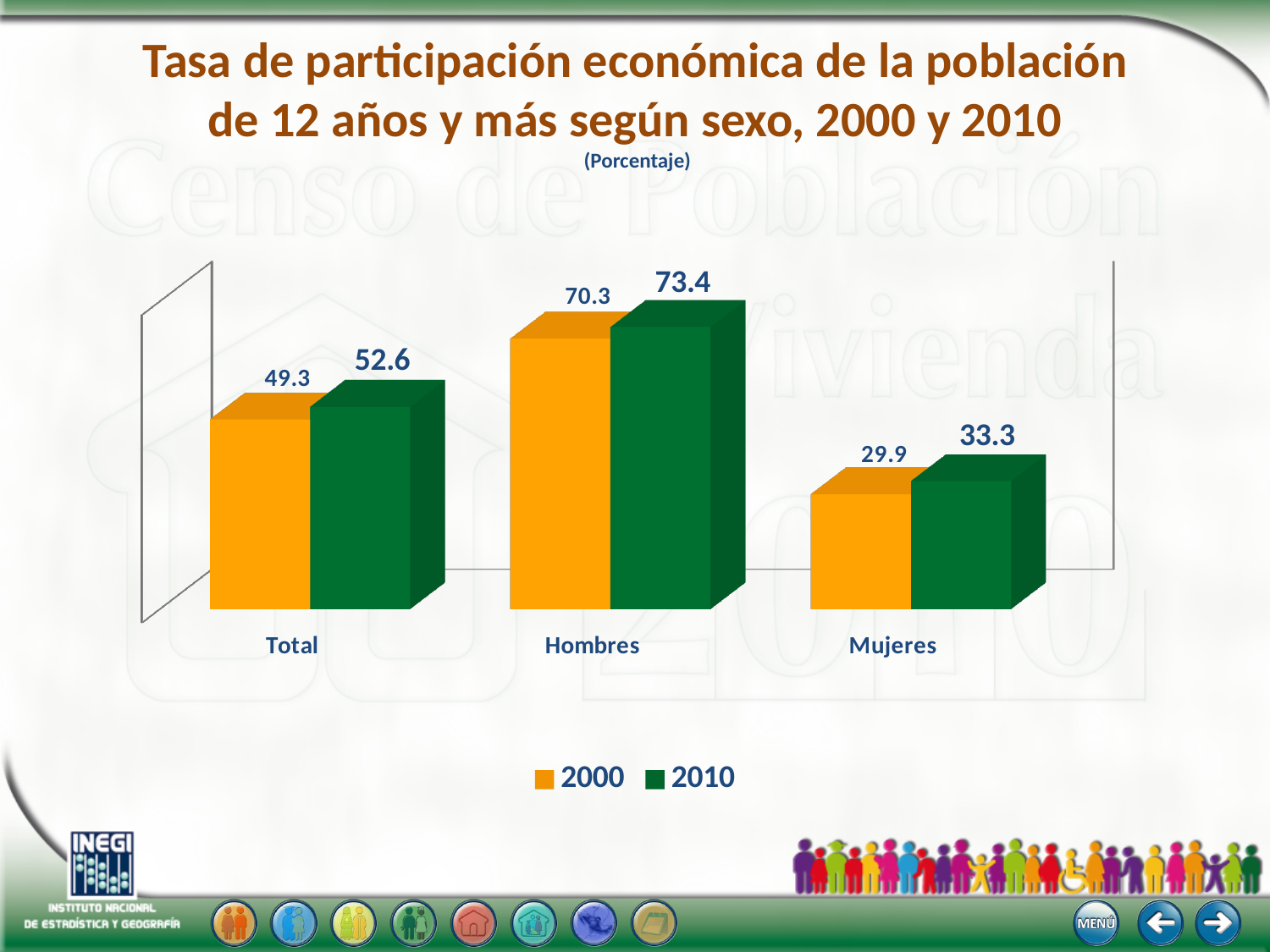
Which colour represents the 2000 series in the legend? orange Which category has the highest value in 2000? Hombres What is the value for Hombres in 2010? 73.4 What kind of chart is shown on the slide? bar chart What is the value for Mujeres in 2000? 29.9 How many categories are shown on the x axis? 3 What is the difference between the Hombres and Mujeres values in 2010? 40.1 What is the difference between the 2010 and 2000 values for Mujeres? 3.4 Which is larger, the Total value in 2000 or the Total value in 2010? 2010 What is the value for Total in 2010? 52.6 Which category has the lowest value in 2010? Mujeres How many series does the legend list? 2